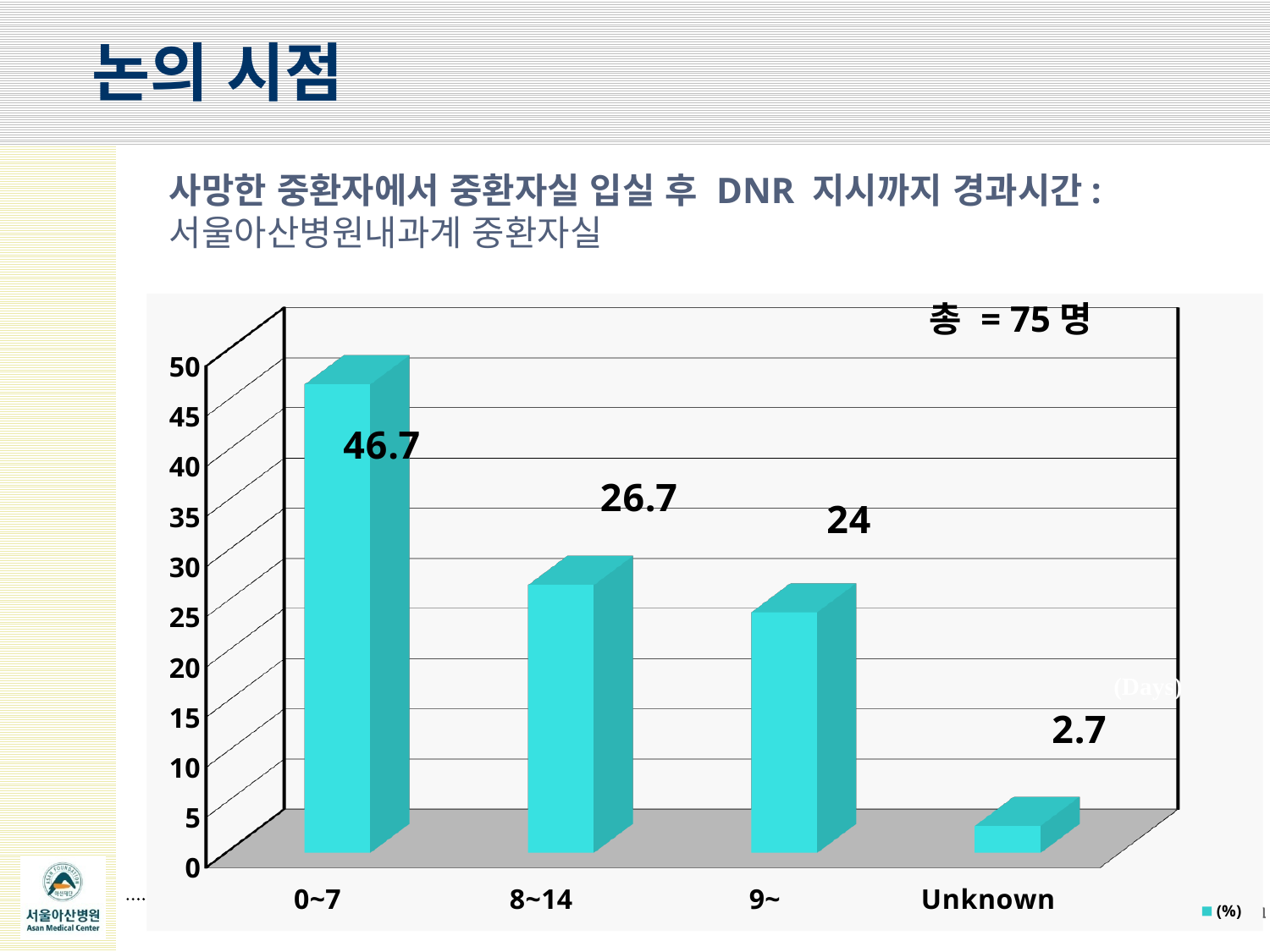
What is the value for the 8~14 category? 26.7 Which is larger, the value for 8~14 or the value for 9~? 8~14 Which category has the lowest value? Unknown What is the value for the 0~7 category? 46.7 Which category has the highest value? 0~7 What is the total number of patients stated on the chart? 75 명 What is the difference between the values for 0~7 and 8~14? 20 What is the value for the Unknown category? 2.7 How many categories are shown on the x axis? 4 Is the value for 0~7 greater or less than 40? greater What is the difference between the values for 9~ and Unknown? 21.3 What kind of chart is shown on the slide? bar chart